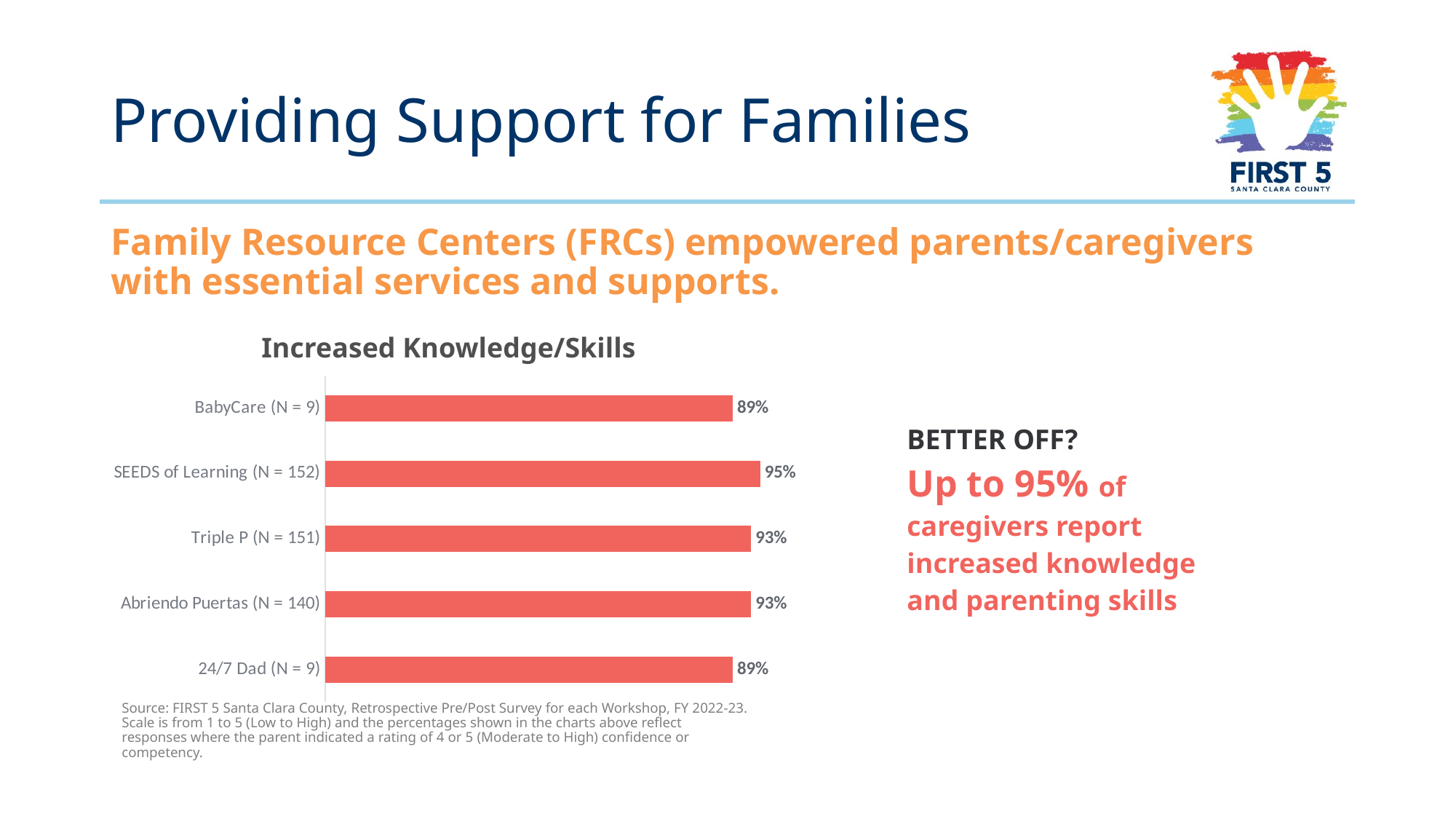
What is the value for 24/7 Dad (N = 9)? 89% Which is larger, the value for SEEDS of Learning (N = 152) or the value for Abriendo Puertas (N = 140)? SEEDS of Learning (N = 152) What is the value for Triple P (N = 151)? 93% What is the value for BabyCare (N = 9)? 89% What colour are the bars in the chart? Red What kind of chart is shown on the slide? Bar chart Which category has the highest value? SEEDS of Learning (N = 152) What is the value for SEEDS of Learning (N = 152)? 95% How many categories are shown in the chart? 5 What is the title of the chart? Increased Knowledge/Skills What is the difference between the values for SEEDS of Learning (N = 152) and BabyCare (N = 9)? 6% What is the difference between the values for Triple P (N = 151) and 24/7 Dad (N = 9)? 4%